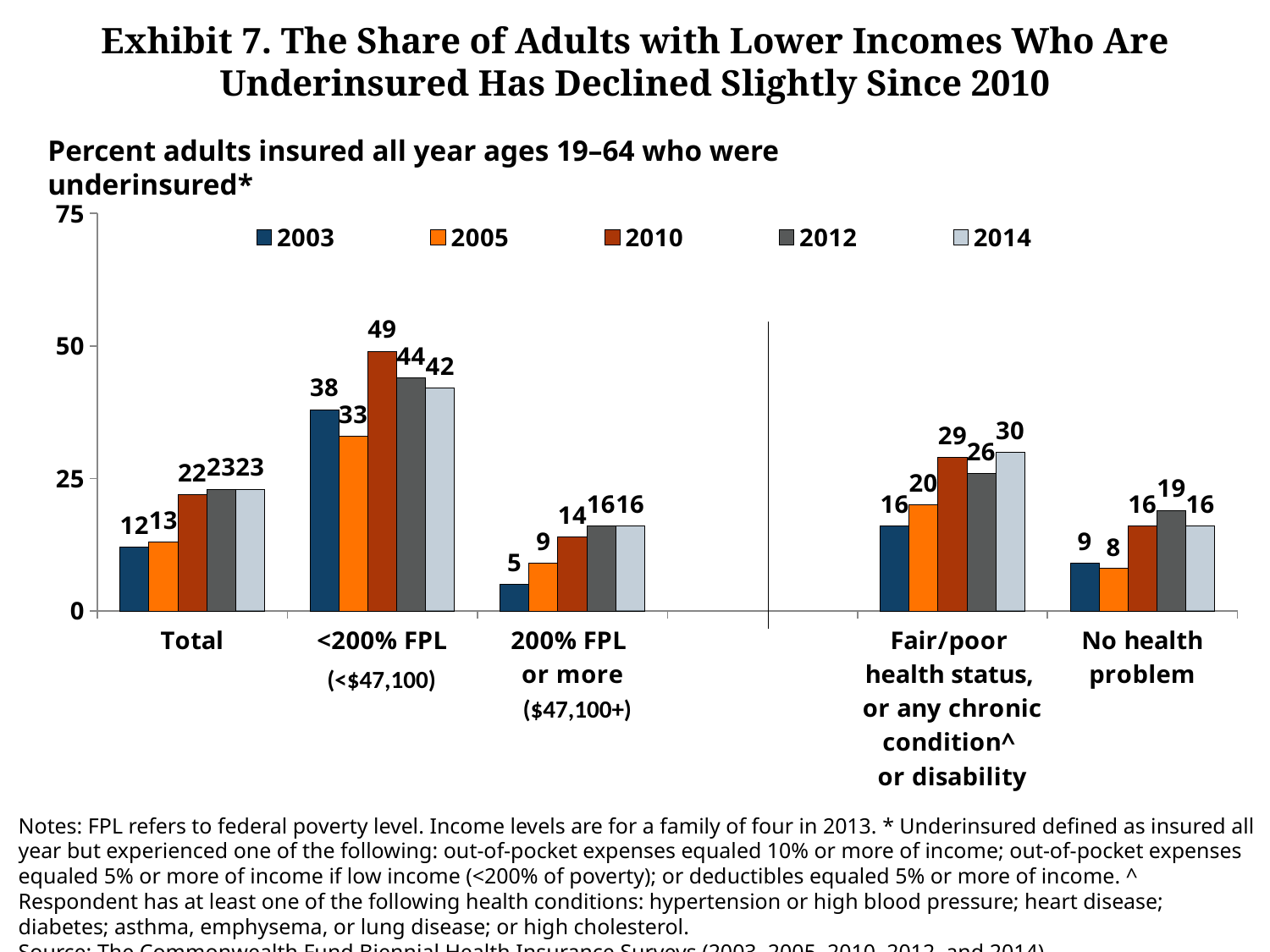
What is the difference between the 2010 and 2014 values in the <200% FPL category? 7 Do the values for the Total category rise or fall from 2003 to 2014? Rise Which year has the lowest value in the 200% FPL or more category? 2003 How many categories are shown on the x axis? 5 What is the value for 2014 in the No health problem category? 16 What is the value for 2003 in the Total category? 12 Which is larger in the Fair/poor health status category: the 2012 value or the 2014 value? 2014 How many series does the legend list? 5 What is the value for 2010 in the <200% FPL category? 49 What kind of chart is shown on the slide? Bar chart What is the difference between the 2005 and 2003 values in the Fair/poor health status category? 4 Which year has the highest value in the <200% FPL category? 2010